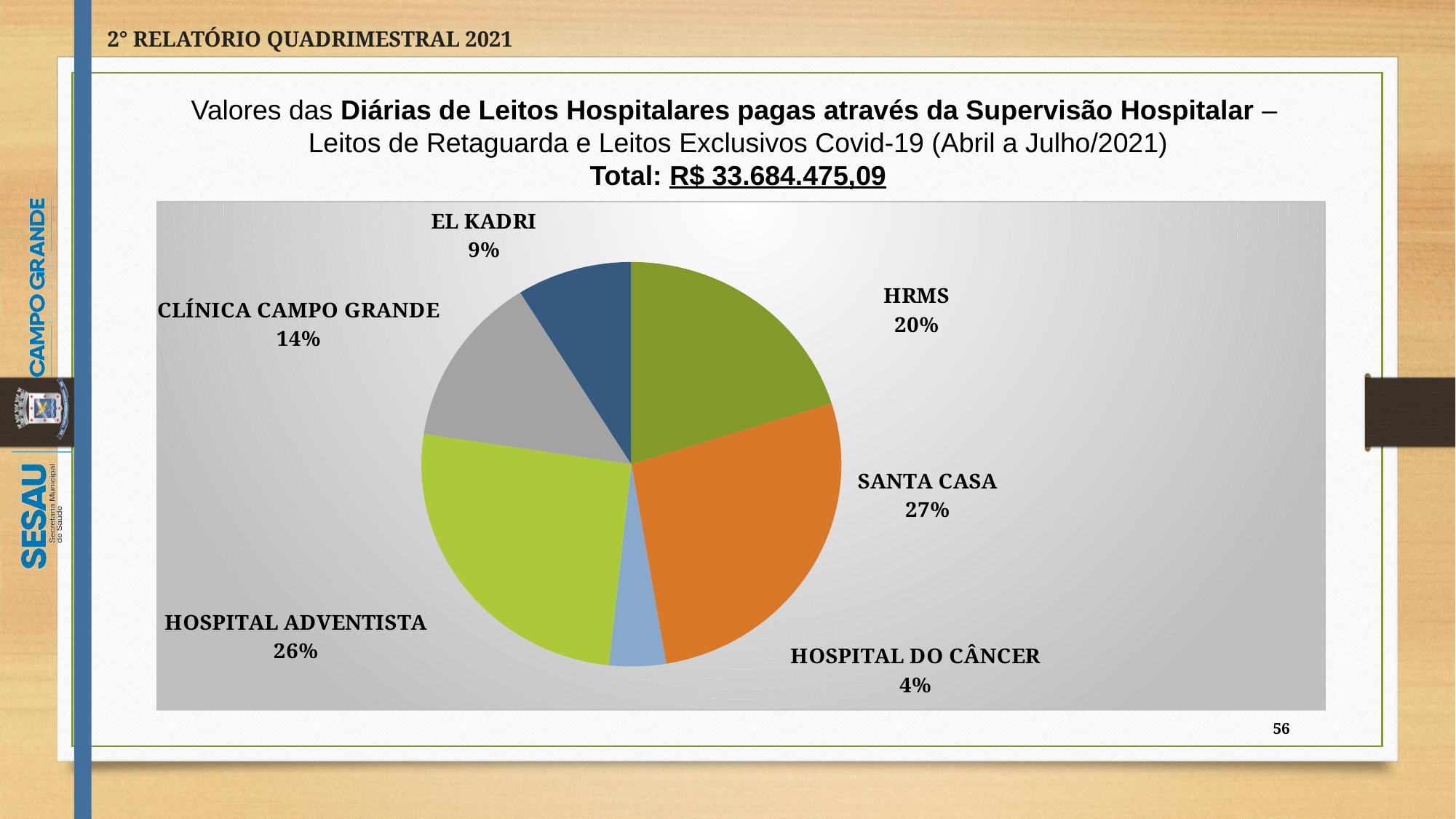
What is the difference in percentage points between HOSPITAL ADVENTISTA and CLÍNICA CAMPO GRANDE? 12 What share of the pie does SANTA CASA represent? 27% What type of chart is shown on the slide? pie chart Which category has the largest share of the pie? SANTA CASA How many slices does the pie chart have? 6 What percentage is shown for HRMS? 20% Which category has the smallest share of the pie? HOSPITAL DO CÂNCER What total value is stated above the chart? R$ 33.684.475,09 Which is larger, the share for HRMS or the share for CLÍNICA CAMPO GRANDE? HRMS What percentage is shown for HOSPITAL DO CÂNCER? 4% What colour is the SANTA CASA slice? orange What percentage is shown for EL KADRI? 9%